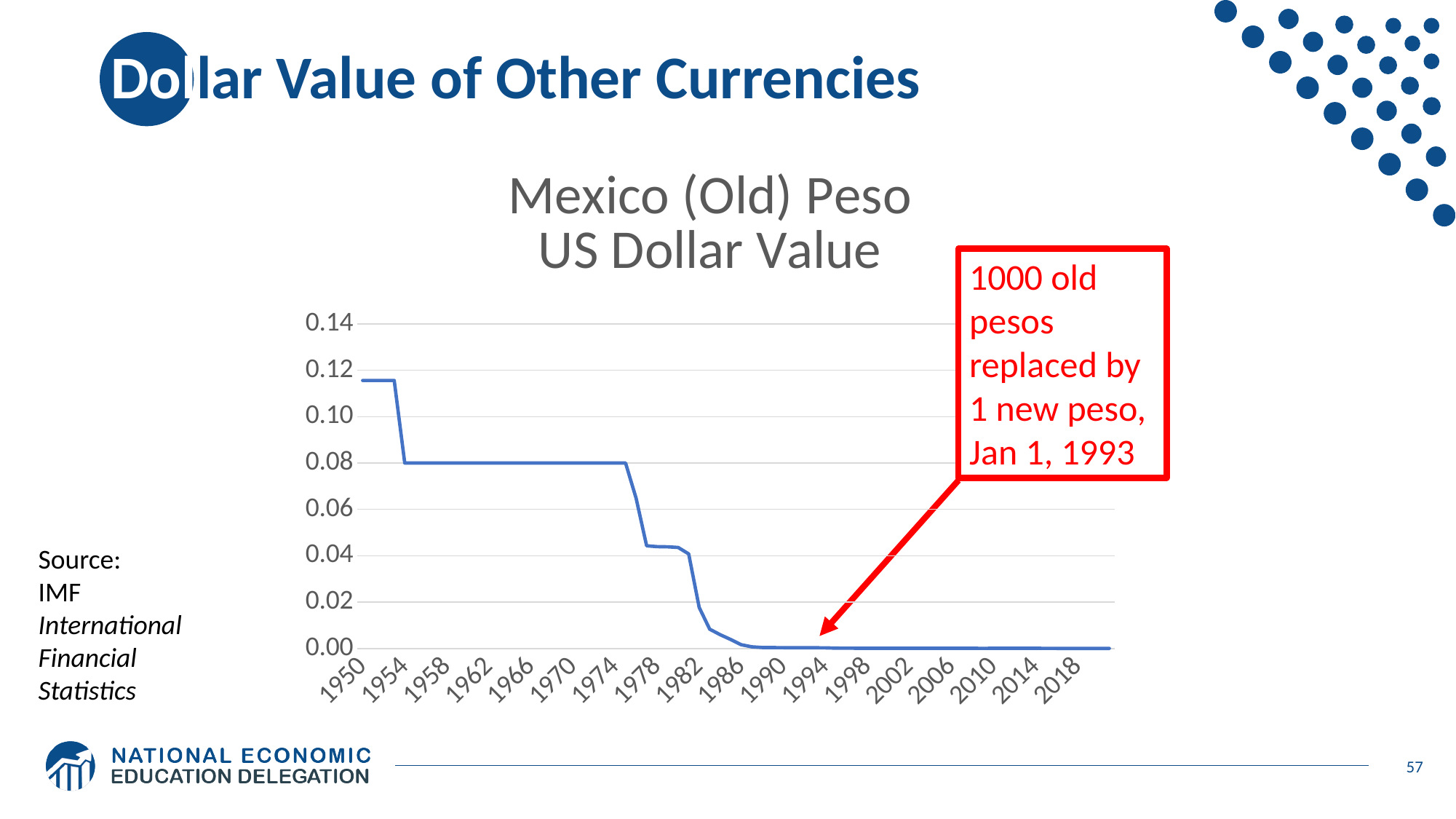
Is the value for 1978 greater or less than 0.04? greater What kind of chart is shown on the slide? line chart What is the title of the chart? Mexico (Old) Peso US Dollar Value Is the value for 1966 greater or less than 0.10? less Is the value in 1970 larger or smaller than the value in 1986? larger How many year labels are shown on the x axis? 18 Is the value for 1990 greater or less than 0.02? less Which year shown on the x axis has the highest US dollar value of the old peso? 1950 Do the values rise or fall from 1950 to 2018? fall What is the US dollar value of the old peso in 1966? 0.08